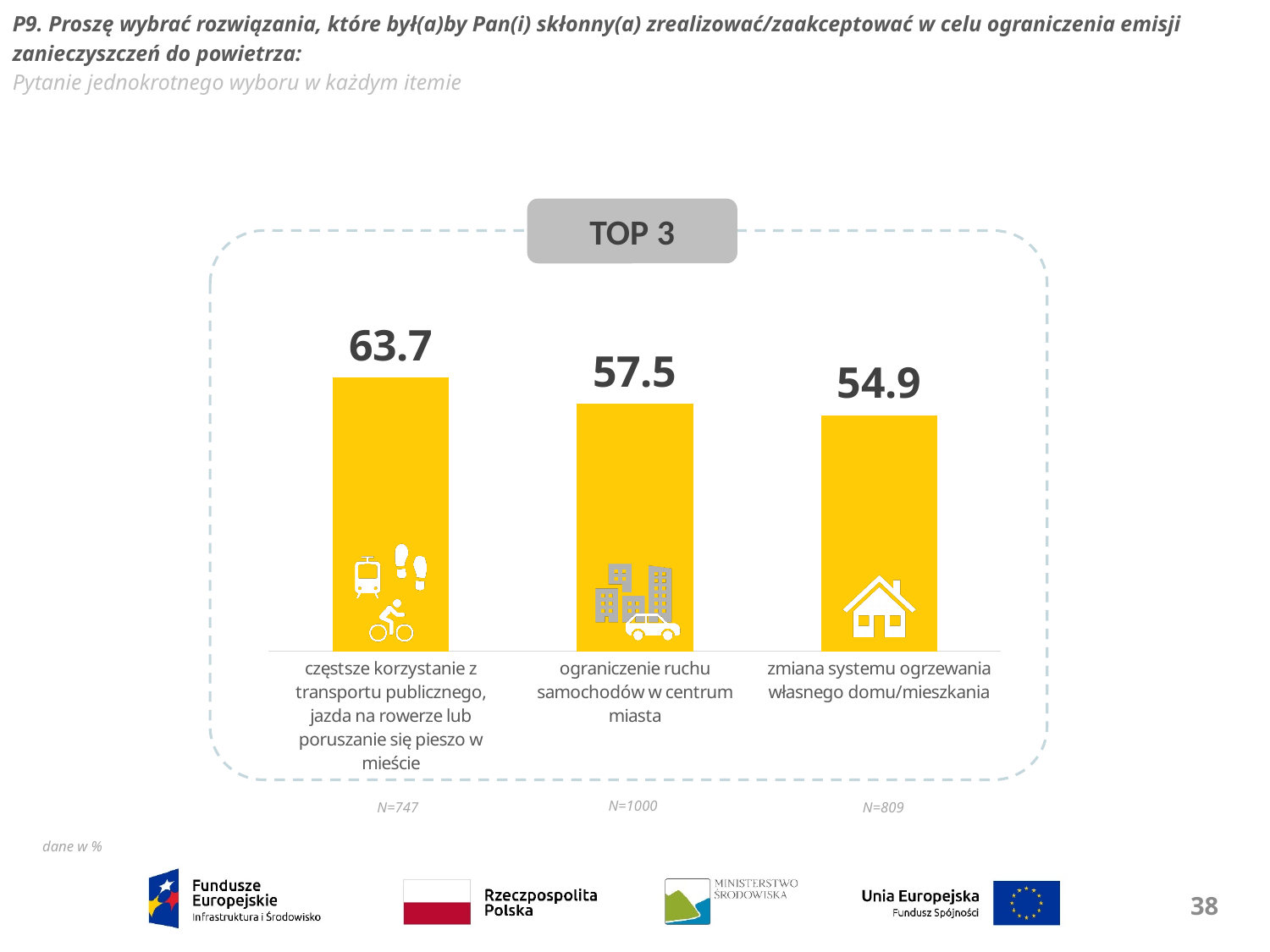
Which category has the highest value? częstsze korzystanie z transportu publicznego, jazda na rowerze lub poruszanie się pieszo w mieście What is the value for "ograniczenie ruchu samochodów w centrum miasta"? 57.5 Which category has the lowest value? zmiana systemu ogrzewania własnego domu/mieszkania What kind of chart is shown on the slide? bar chart What is the difference between the values for "ograniczenie ruchu samochodów w centrum miasta" and "zmiana systemu ogrzewania własnego domu/mieszkania"? 2.6 How many categories are shown in the chart? 3 Which is larger: the value for "ograniczenie ruchu samochodów w centrum miasta" or for "zmiana systemu ogrzewania własnego domu/mieszkania"? ograniczenie ruchu samochodów w centrum miasta What is the value for "częstsze korzystanie z transportu publicznego, jazda na rowerze lub poruszanie się pieszo w mieście"? 63.7 What is the difference between the values for "częstsze korzystanie z transportu publicznego..." and "ograniczenie ruchu samochodów w centrum miasta"? 6.2 What is the label in the grey box above the chart? TOP 3 What is the value for "zmiana systemu ogrzewania własnego domu/mieszkania"? 54.9 Do the values rise or fall from left to right across the categories? fall